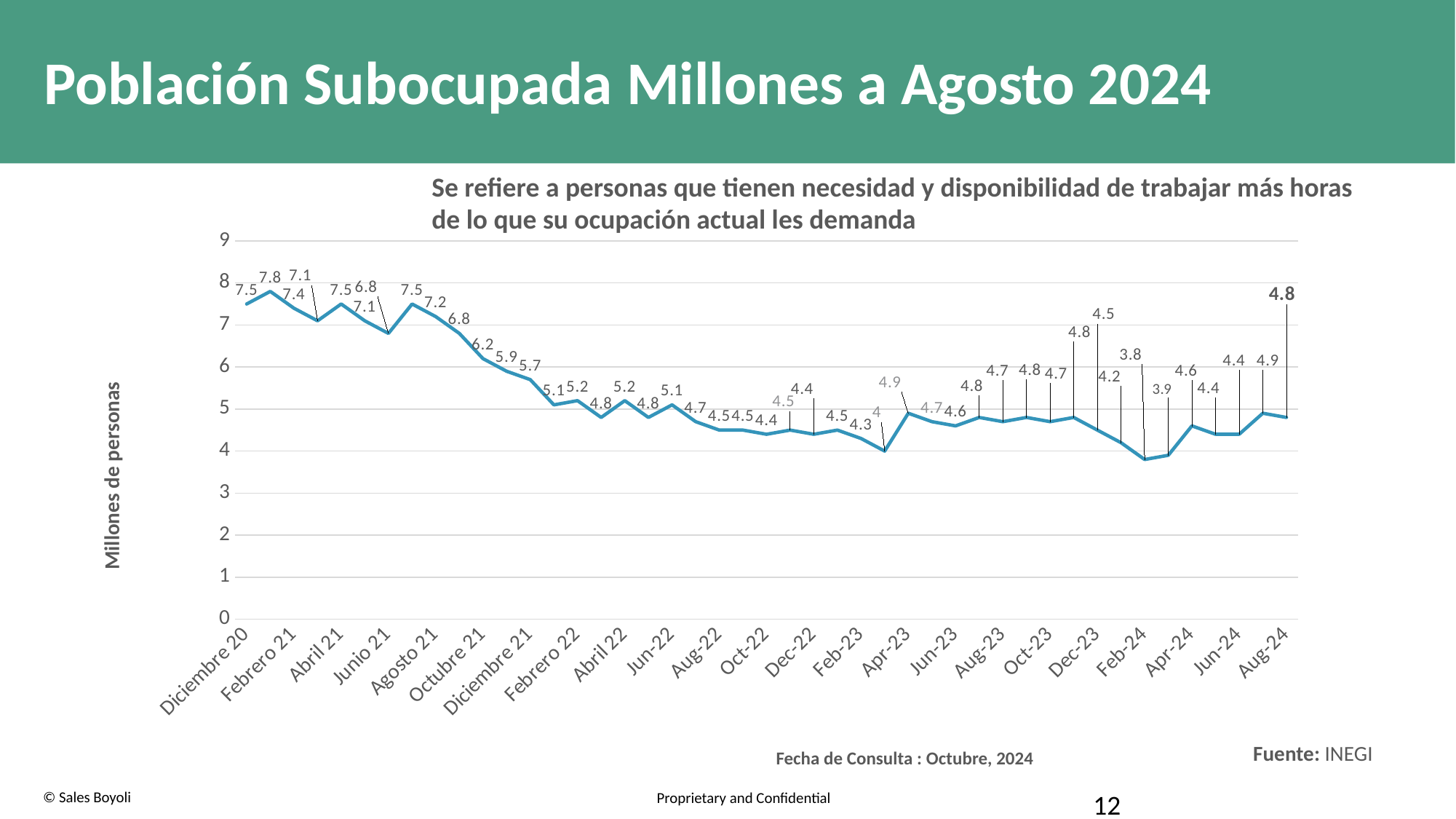
What is the lowest value plotted on the chart? 3.8 Which is larger, the value for Junio 21 or the value for Agosto 21? Agosto 21 What is the value for Octubre 21? 6.2 Is the value for Abril 21 greater or less than 7? greater What is the difference between the value for Diciembre 20 and the value for Aug-24? 2.7 What is the highest value plotted on the chart? 7.8 What kind of chart is shown on the slide? Line chart What is the title of the vertical axis? Millones de personas What is the value for Aug-24? 4.8 Overall, do the values rise or fall from Diciembre 20 to Aug-24? Fall What is the value for Diciembre 20? 7.5 What is the value for Feb-24? 3.8